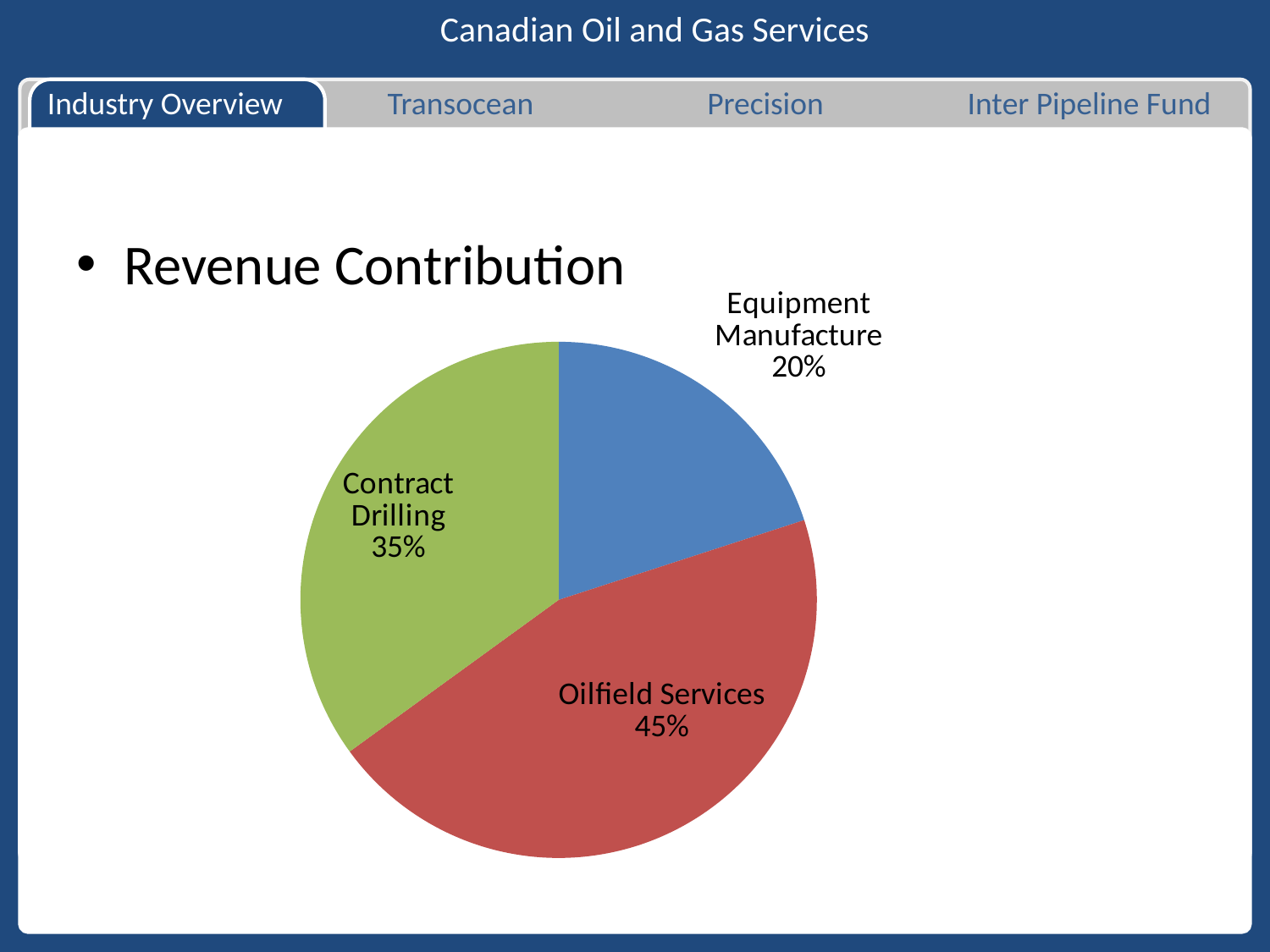
What is the difference in percentage points between Contract Drilling and Equipment Manufacture? 15 What is the heading above the pie chart? Revenue Contribution How many segments does the pie chart have? 3 Which segment has the largest share of the pie? Oilfield Services What share of revenue does Oilfield Services contribute? 45% What colour is the Oilfield Services slice? red What kind of chart is shown on the slide? pie chart What share of revenue does Contract Drilling contribute? 35% What is the difference in percentage points between Oilfield Services and Contract Drilling? 10 Which is larger, the share for Contract Drilling or the share for Equipment Manufacture? Contract Drilling Which segment has the smallest share of the pie? Equipment Manufacture What share of revenue does Equipment Manufacture contribute? 20%